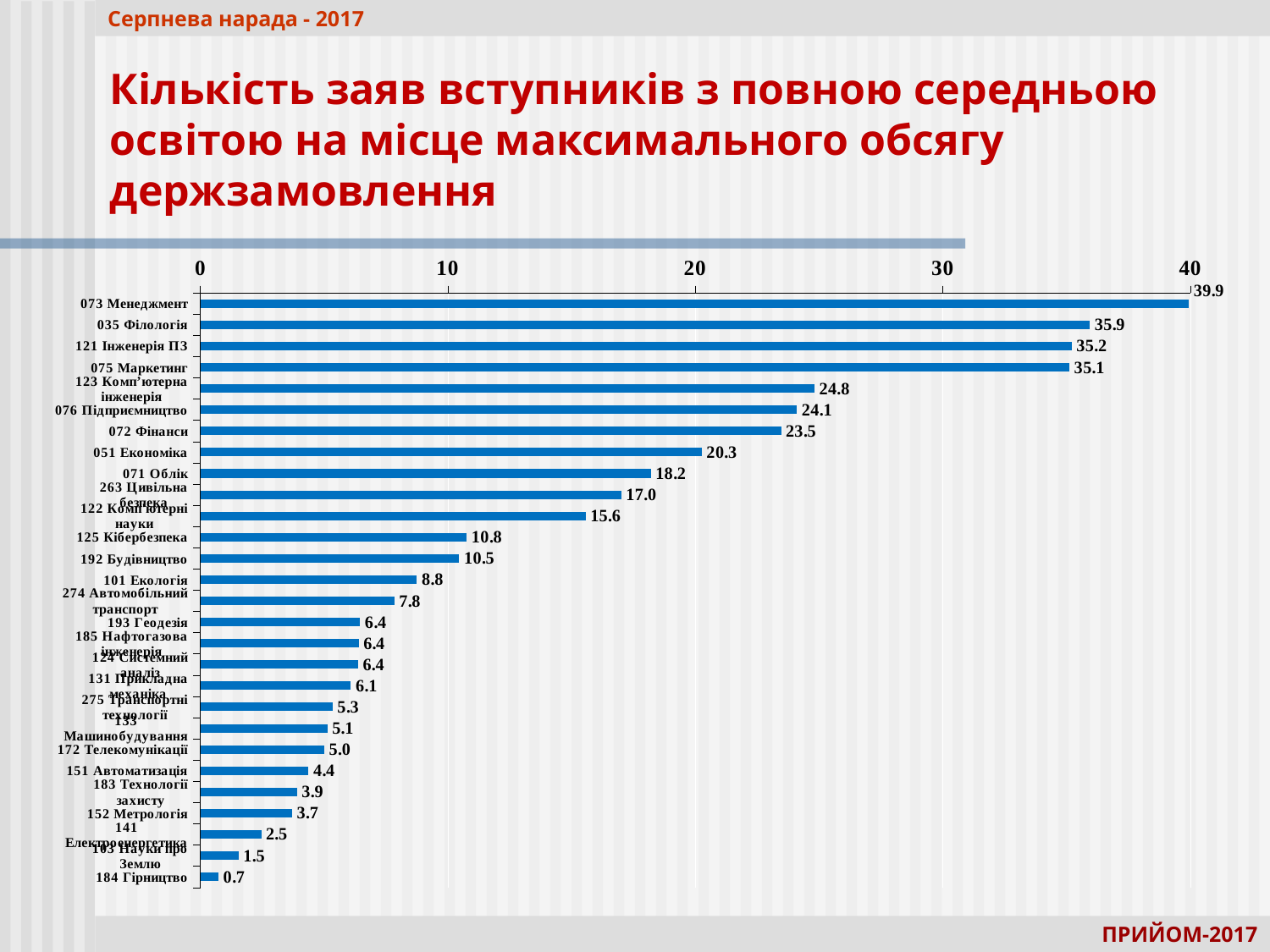
What is the value for 125 Кібербезпека? 10.8 What is the value for 073 Менеджмент? 39.9 What is the value for 072 Фінанси? 23.5 How many categories are plotted in the chart? 28 Which category has the highest value? 073 Менеджмент Which category has the lowest value? 184 Гірництво What is the value for 184 Гірництво? 0.7 What kind of chart is shown on the slide? bar chart Which is larger, the value for 051 Економіка or the value for 071 Облік? 051 Економіка Is the value for 123 Комп'ютерна інженерія greater or less than 20? greater What is the maximum value shown on the horizontal axis? 40 What is the difference between the values for 035 Філологія and 075 Маркетинг? 0.8